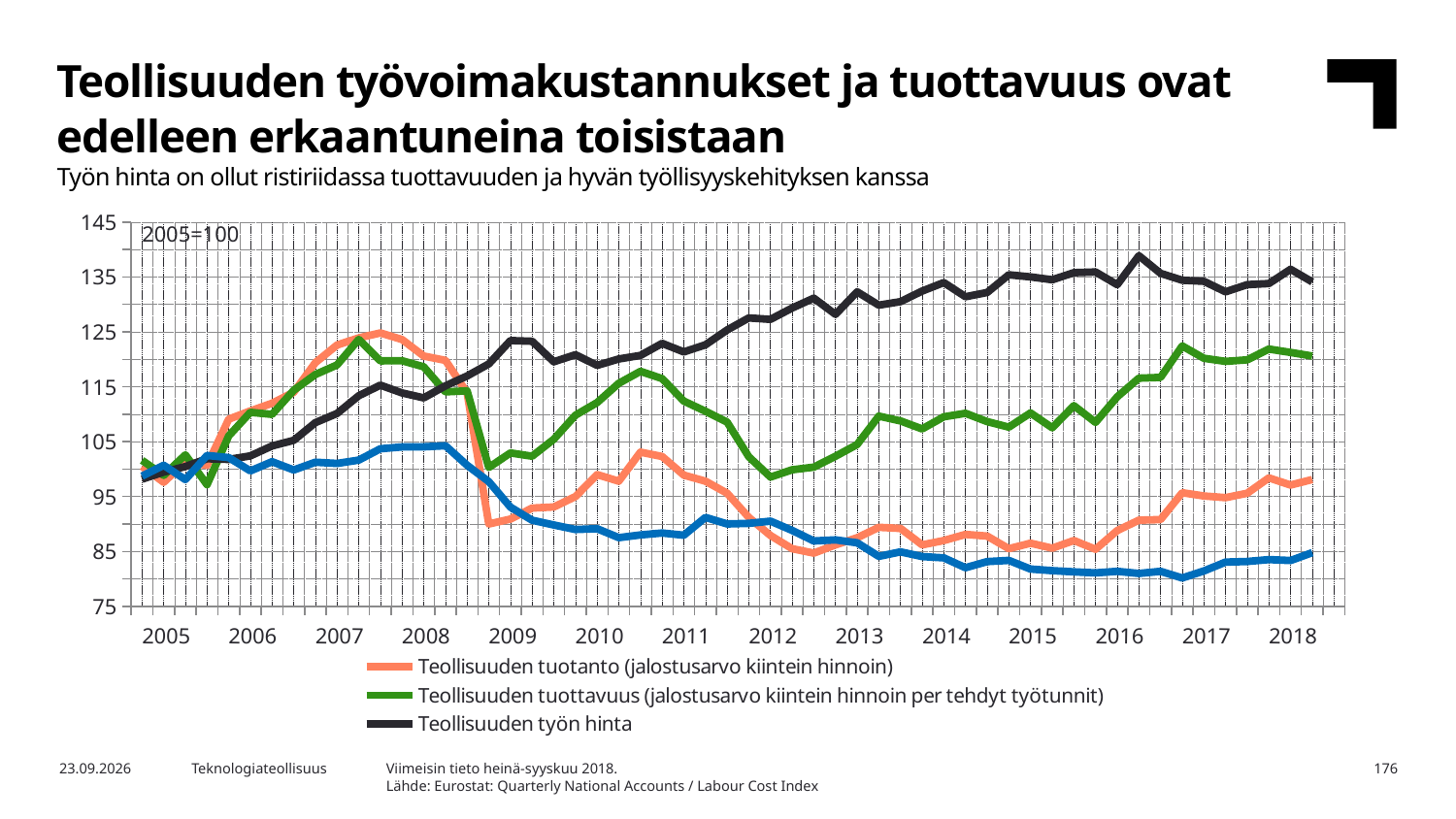
Is the value of Teollisuuden tuotanto at the start of 2009 greater or less than 95? less What colour is the line for Teollisuuden työn hinta? black In 2012, which is higher: Teollisuuden tuottavuus or Teollisuuden tuotanto? Teollisuuden tuottavuus How many year labels are shown on the x axis? 14 Is the value of Teollisuuden tuottavuus at its low point in 2012 greater or less than 105? less Is the peak value of Teollisuuden tuotanto in 2007 greater or less than 115? greater What kind of chart is shown on the slide? line chart What base year note is printed in the top-left corner of the plot area? 2005=100 How many series does the legend list? 3 Which series has the highest value at the end of the chart in 2018? Teollisuuden työn hinta Does Teollisuuden työn hinta rise or fall overall from 2005 to 2018? rise